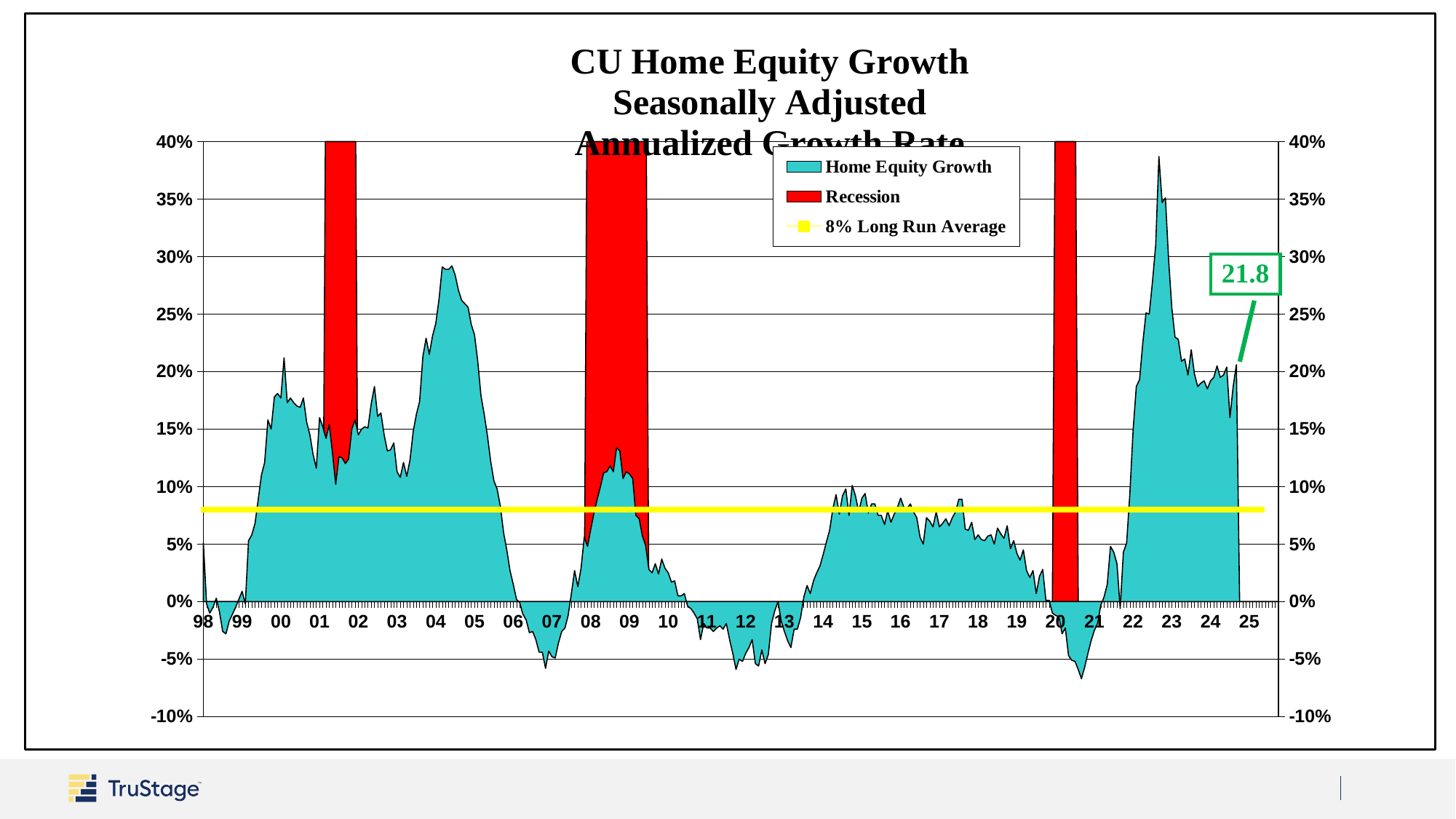
According to the legend, what is the long run average growth rate shown by the yellow line? 8% What is the labeled value for the most recent Home Equity Growth data point? 21.8 What kind of chart is shown on the slide? area chart Is the value for Home Equity Growth in 2017 greater or less than 10%? less Which is higher: the peak of Home Equity Growth around 2022 or the peak around 2004? the peak around 2022 Is the peak value of Home Equity Growth around 2004 greater or less than 25%? greater How many recession periods are marked on the chart? 3 Between 2015 and 2019, does Home Equity Growth generally rise or fall? fall Is the value for Home Equity Growth in 2012 greater or less than 0%? less How many series does the legend list? 3 What is the title of the chart? CU Home Equity Growth Seasonally Adjusted Annualized Growth Rate